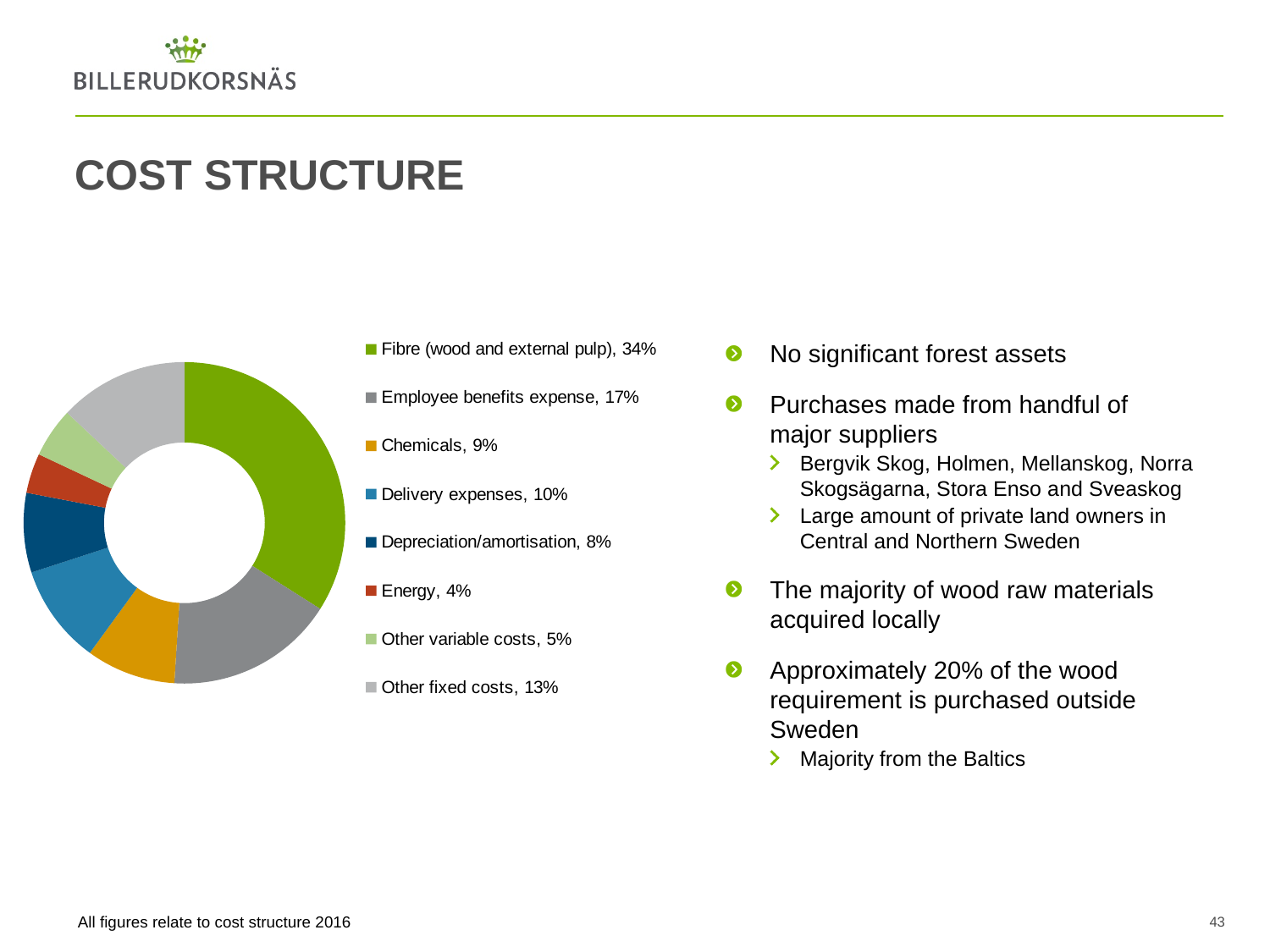
Which is larger: the share for Chemicals or the share for Depreciation/amortisation? Chemicals What share of the cost structure is Delivery expenses? 10% Which cost category has the smallest share of the cost structure? Energy What is the combined share of Other variable costs and Other fixed costs? 18% Which cost category has the largest share of the cost structure? Fibre (wood and external pulp) What share of the cost structure is Fibre (wood and external pulp)? 34% What share of the cost structure is Employee benefits expense? 17% How many cost categories are shown in the chart? 8 What is the difference in percentage points between Fibre (wood and external pulp) and Employee benefits expense? 17 What share of the cost structure is Energy? 4% What kind of chart is used to show the cost structure? Pie chart (doughnut) Which year do the figures in the chart relate to? 2016